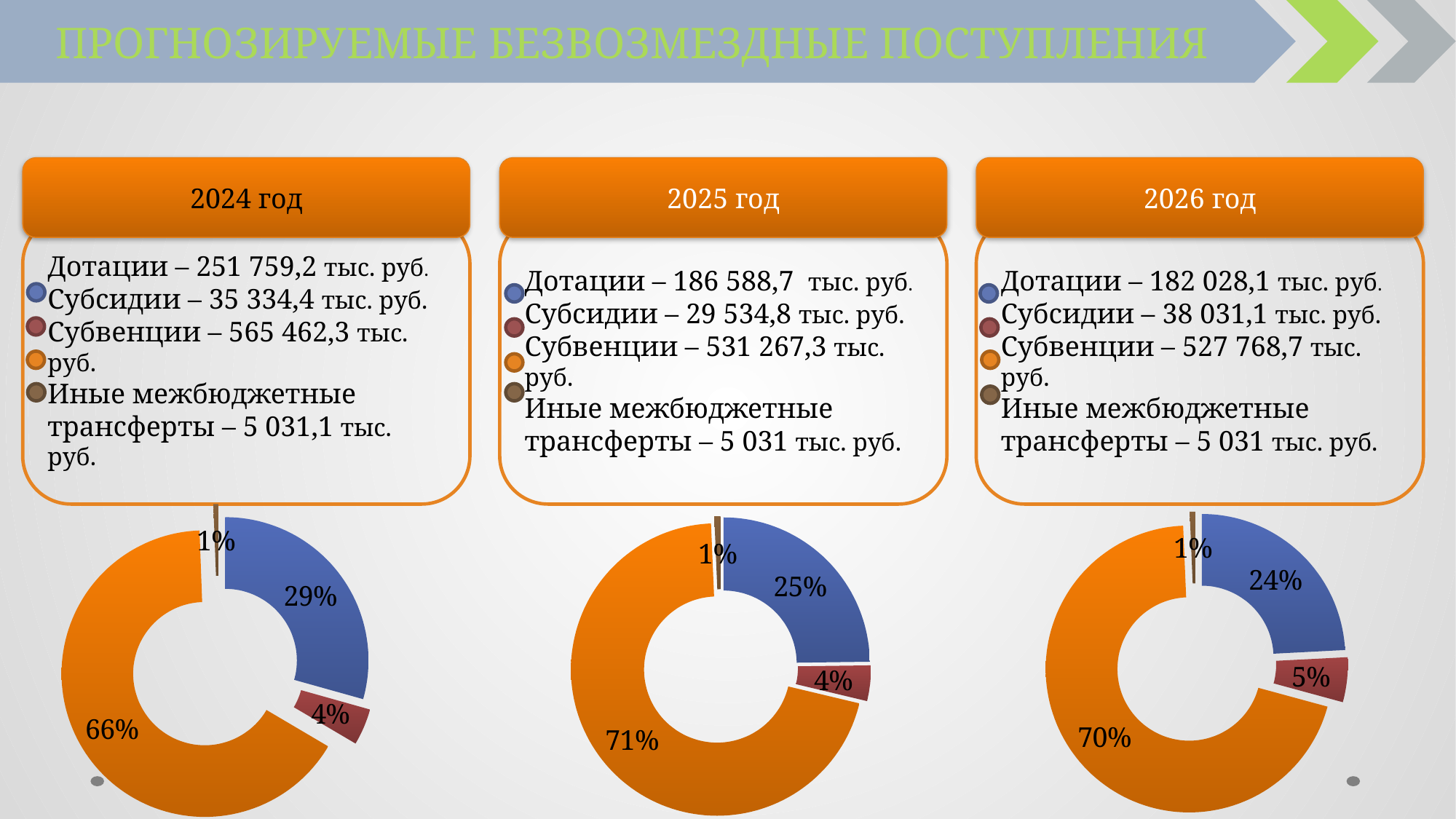
In the 2026 год chart, what share is shown for Субсидии? 5% What kind of chart is used for each year on the slide? Doughnut (pie) chart What colour represents Субвенции in the charts? Orange In the 2024 год chart, which category has the largest slice? Субвенции In the 2024 год chart, by how many percentage points does the Субвенции share exceed the Дотации share? 37 percentage points In the 2025 год chart, which is larger: the Дотации slice or the Субсидии slice? Дотации In the 2026 год chart, what share is shown for Иные межбюджетные трансферты? 1% Across the 2024, 2025 and 2026 charts, does the share of Дотации rise or fall? Fall In the 2025 год chart, what share is shown for Дотации? 25% In the 2026 год chart, which category has the smallest slice? Иные межбюджетные трансферты How many slices does the 2025 год chart have? 4